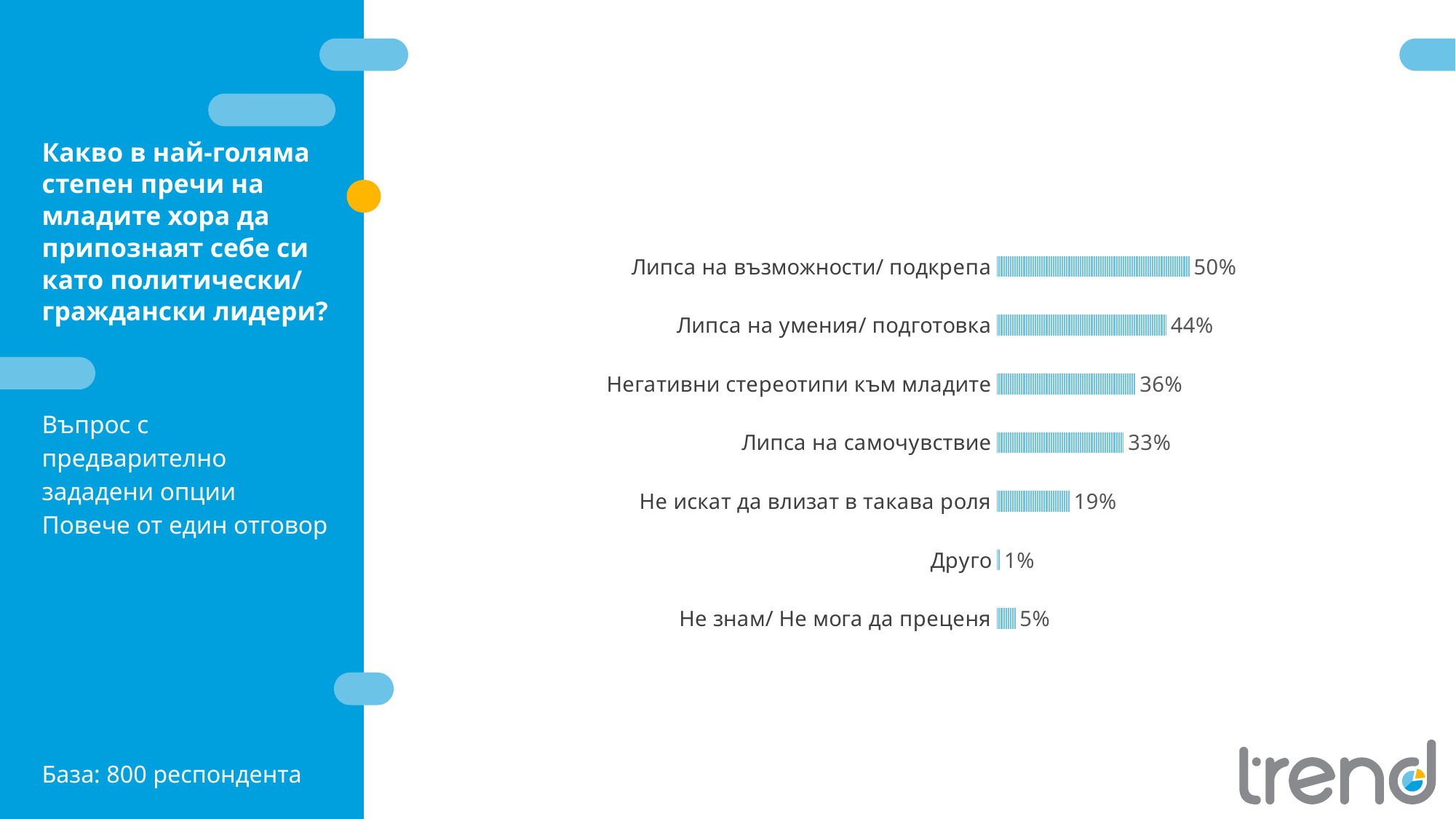
Which is larger: "Негативни стереотипи към младите" or "Не искат да влизат в такава роля"? Негативни стереотипи към младите What is the difference between "Липса на умения/ подготовка" and "Липса на самочувствие"? 11% What is the value for "Негативни стереотипи към младите"? 36% Which category has the highest value? Липса на възможности/ подкрепа What is the value for "Не знам/ Не мога да преценя"? 5% How many respondents form the base of the survey, according to the slide? 800 What kind of chart is shown on the slide? Bar chart What is the difference between "Липса на възможности/ подкрепа" and "Не знам/ Не мога да преценя"? 45% Which category has the lowest value? Друго What is the value for "Липса на възможности/ подкрепа"? 50% How many categories are shown in the chart? 7 What is the value for "Не искат да влизат в такава роля"? 19%